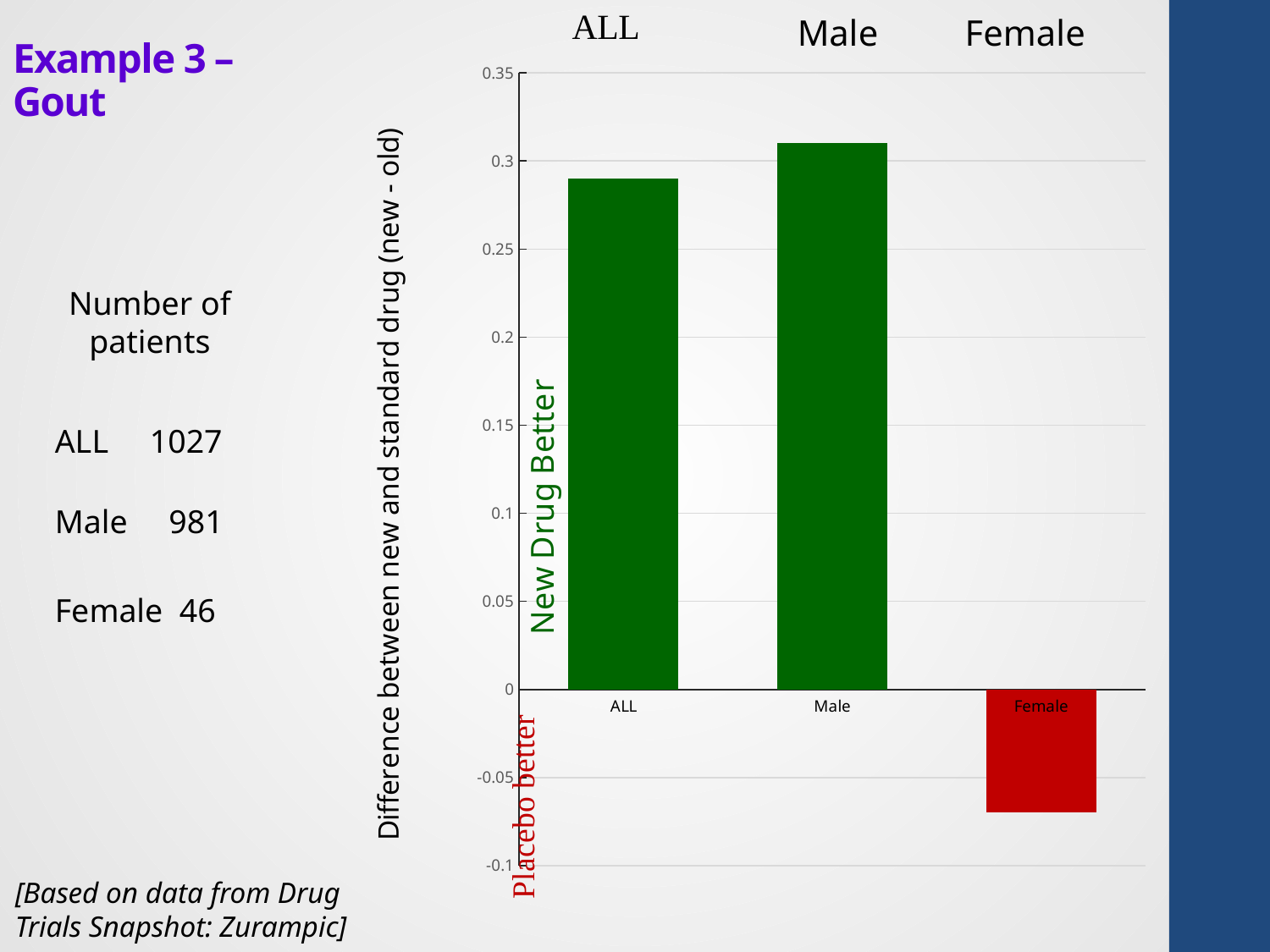
Is the value for Female greater or less than -0.05? less Which category has a negative value in the chart? Female Is the value for Female greater or less than -0.1? greater Which category has the highest value in the chart? Male Which is larger, the value for ALL or the value for Male? Male Is the value for ALL greater or less than 0.25? greater How many categories are plotted in the chart? 3 What is the label of the vertical axis of the chart? Difference between new and standard drug (new - old) Which category has the lowest value in the chart? Female What kind of chart is shown on the slide? bar chart